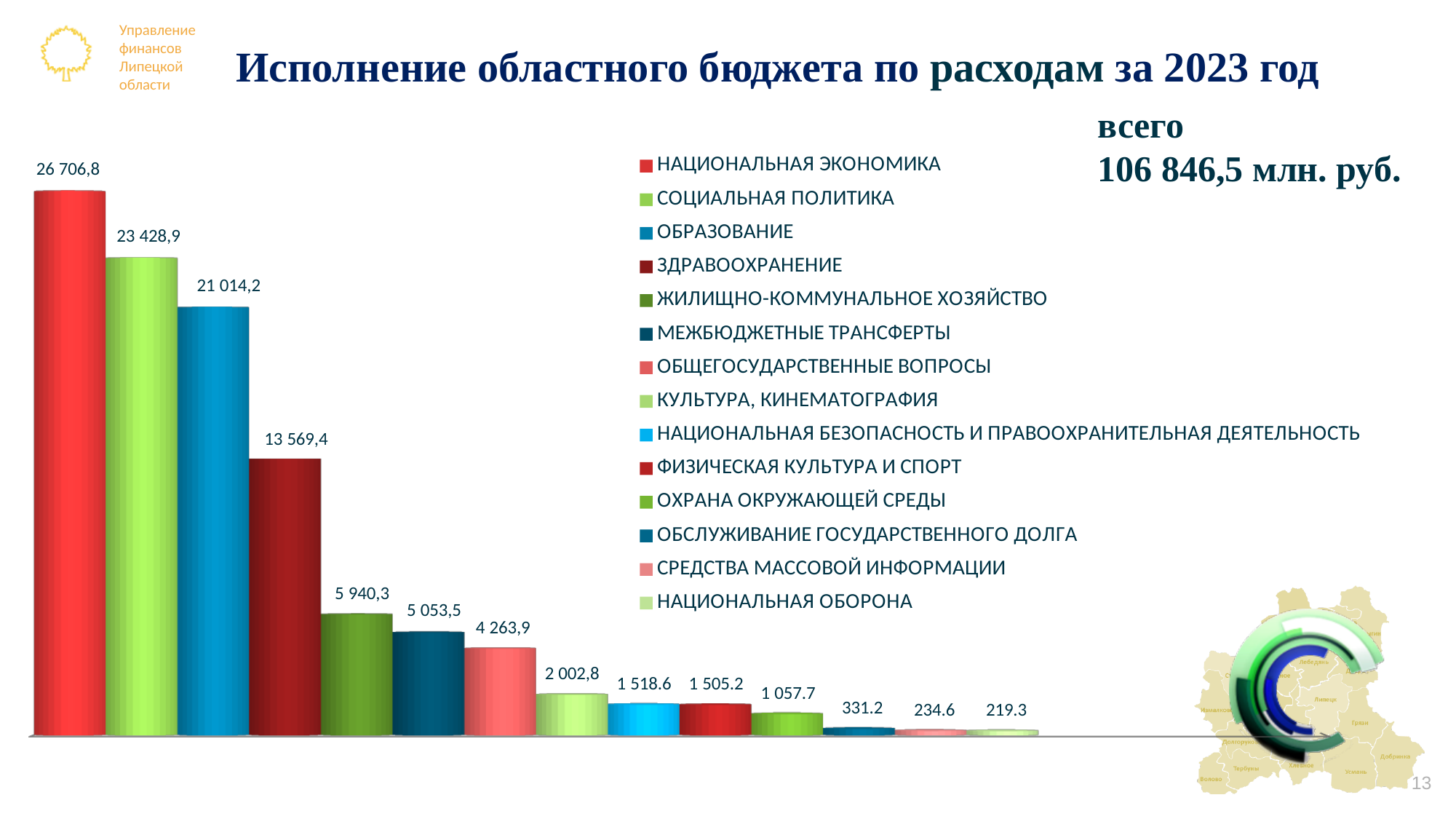
What is the value for ОБСЛУЖИВАНИЕ ГОСУДАРСТВЕННОГО ДОЛГА? 331.2 What is the value for НАЦИОНАЛЬНАЯ ЭКОНОМИКА? 26 706,8 What is the difference between the values for НАЦИОНАЛЬНАЯ ЭКОНОМИКА and СОЦИАЛЬНАЯ ПОЛИТИКА? 3 277,9 What is the difference between the values for ЖИЛИЩНО-КОММУНАЛЬНОЕ ХОЗЯЙСТВО and МЕЖБЮДЖЕТНЫЕ ТРАНСФЕРТЫ? 886,8 Which is larger, the value for ОБЩЕГОСУДАРСТВЕННЫЕ ВОПРОСЫ or the value for КУЛЬТУРА, КИНЕМАТОГРАФИЯ? ОБЩЕГОСУДАРСТВЕННЫЕ ВОПРОСЫ How many categories are plotted in the chart? 14 What total expenditure amount is stated on the slide? 106 846,5 млн. руб. What kind of chart is shown on the slide? Bar chart Which category has the lowest value? НАЦИОНАЛЬНАЯ ОБОРОНА Which category has the highest value? НАЦИОНАЛЬНАЯ ЭКОНОМИКА What is the value for ОБРАЗОВАНИЕ? 21 014,2 What is the value for ЗДРАВООХРАНЕНИЕ? 13 569,4